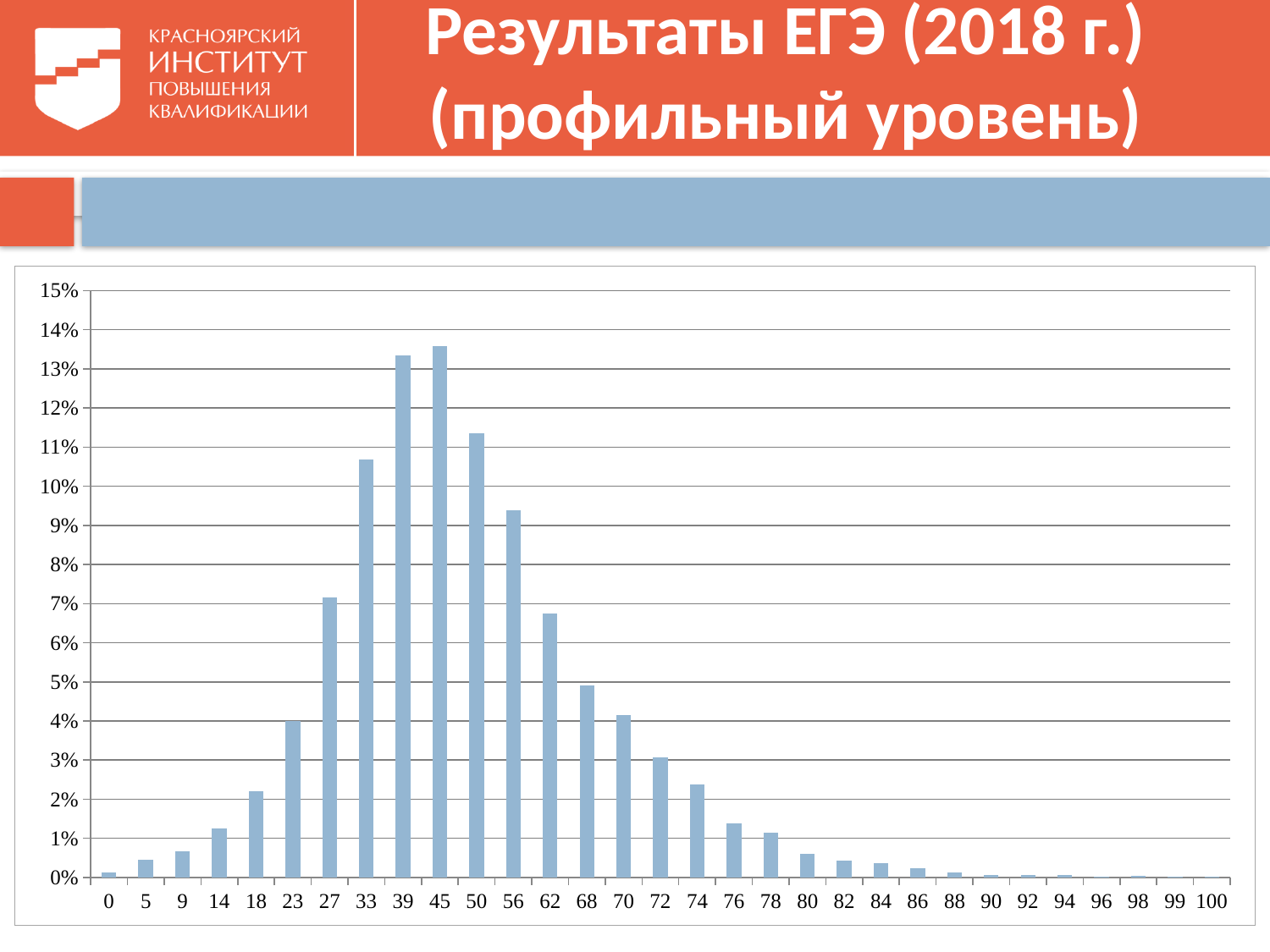
Is the value for 80 greater or less than 1%? less Which is larger, the value for 68 or the value for 70? 68 How many categories are shown on the x axis of the chart? 31 Is the value for 33 greater or less than 10%? greater What kind of chart is shown on the slide? bar chart Which is larger, the value for 33 or the value for 56? 33 Is the value for 45 greater or less than 13%? greater Do the values rise or fall along the x axis from 45 to 100? fall What is the highest value shown on the y axis of the chart? 15%